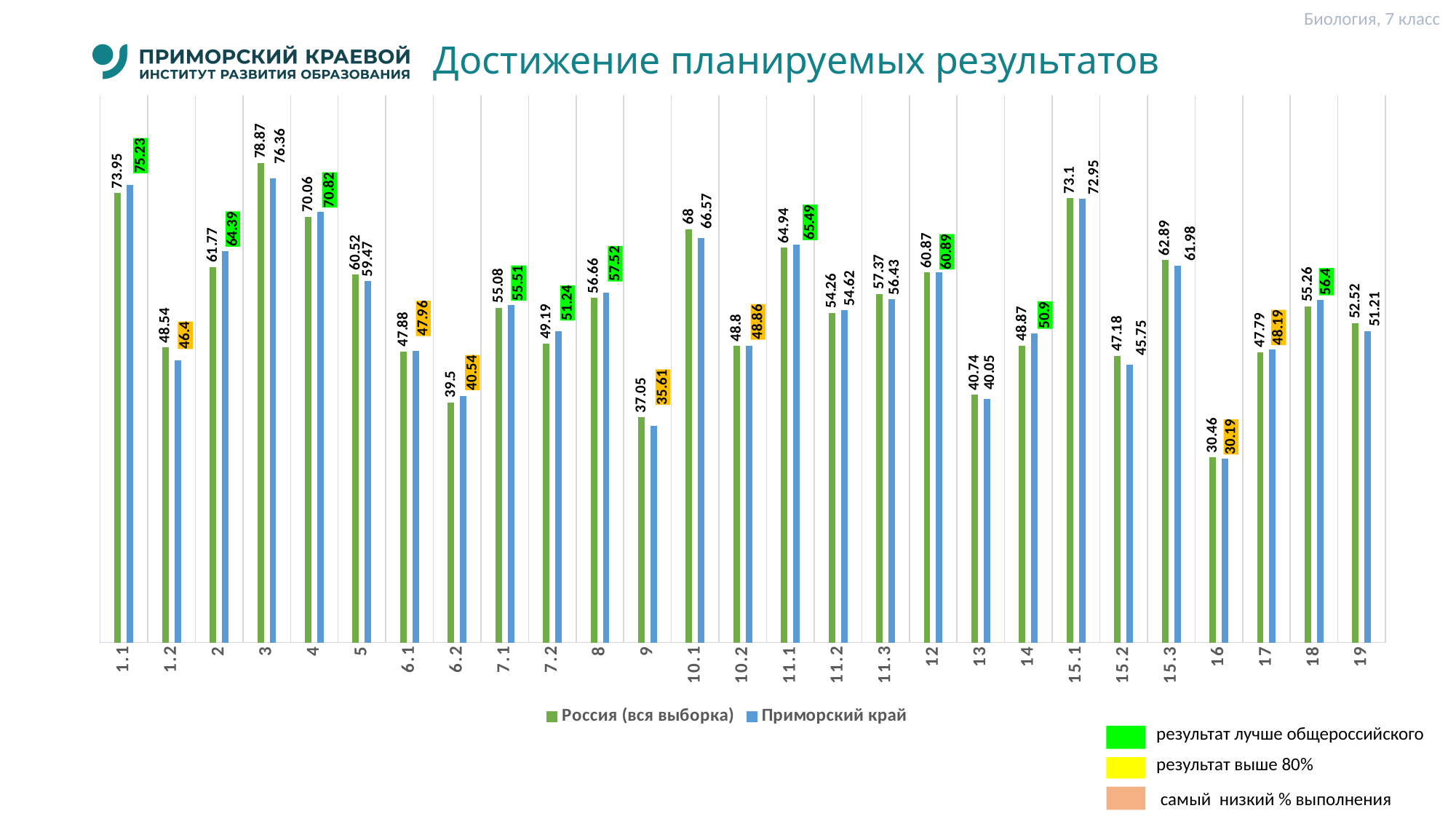
What is the value for Россия (вся выборка) for task 9? 37.05 Which task has the highest value for Россия (вся выборка)? 3 Which task has the lowest value for Приморский край? 16 How many series does the legend list? 2 What is the value for Приморский край for task 1.1? 75.23 How many task categories are shown along the x axis? 27 What is the title of the chart? Достижение планируемых результатов For task 2, which series has the larger value: Россия (вся выборка) or Приморский край? Приморский край For task 15.2, which series has the larger value: Россия (вся выборка) or Приморский край? Россия (вся выборка) What is the value for Приморский край for task 14? 50.9 What type of chart is shown on the slide? bar chart What is the difference between the Россия (вся выборка) and Приморский край values for task 3? 2.51